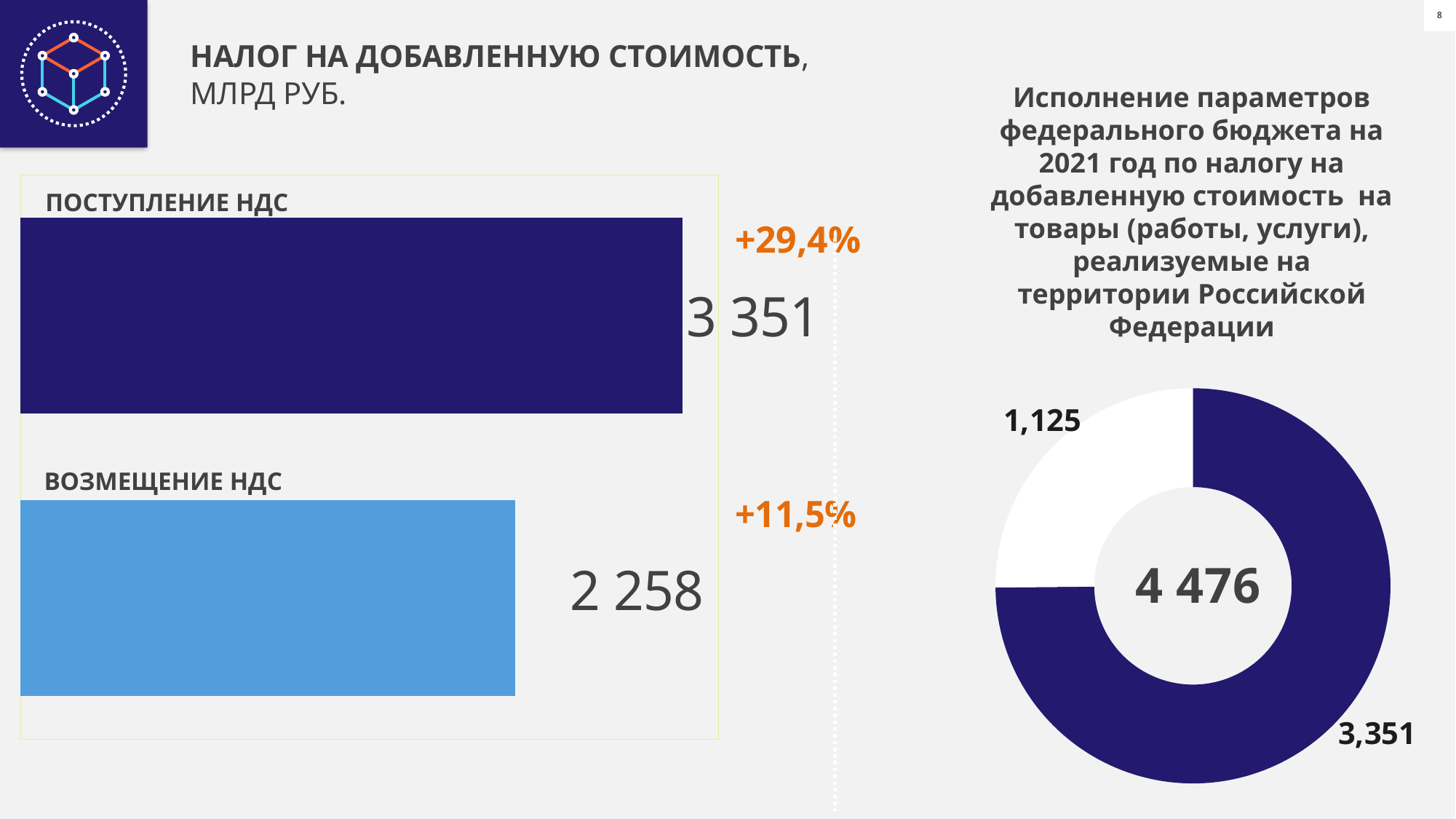
On the left bar chart, what percentage change is shown next to ВОЗМЕЩЕНИЕ НДС? +11,5% On the left bar chart, what is the value for ВОЗМЕЩЕНИЕ НДС? 2 258 On the right donut chart, what total value is shown in the centre? 4 476 On the left bar chart, which category has the higher value? ПОСТУПЛЕНИЕ НДС On the left bar chart, what is the value for ПОСТУПЛЕНИЕ НДС? 3 351 On the right donut chart, which segment is larger, the one labelled 3,351 or the one labelled 1,125? 3,351 On the left bar chart, which category has the lower value? ВОЗМЕЩЕНИЕ НДС On the left bar chart, what is the difference between ПОСТУПЛЕНИЕ НДС and ВОЗМЕЩЕНИЕ НДС? 1 093 On the left bar chart, what percentage change is shown next to ПОСТУПЛЕНИЕ НДС? +29,4% What kind of chart is shown on the left side of the slide? Bar chart On the right donut chart, what is the value of the smaller (white) segment? 1,125 On the left bar chart, how many bars are plotted? 2